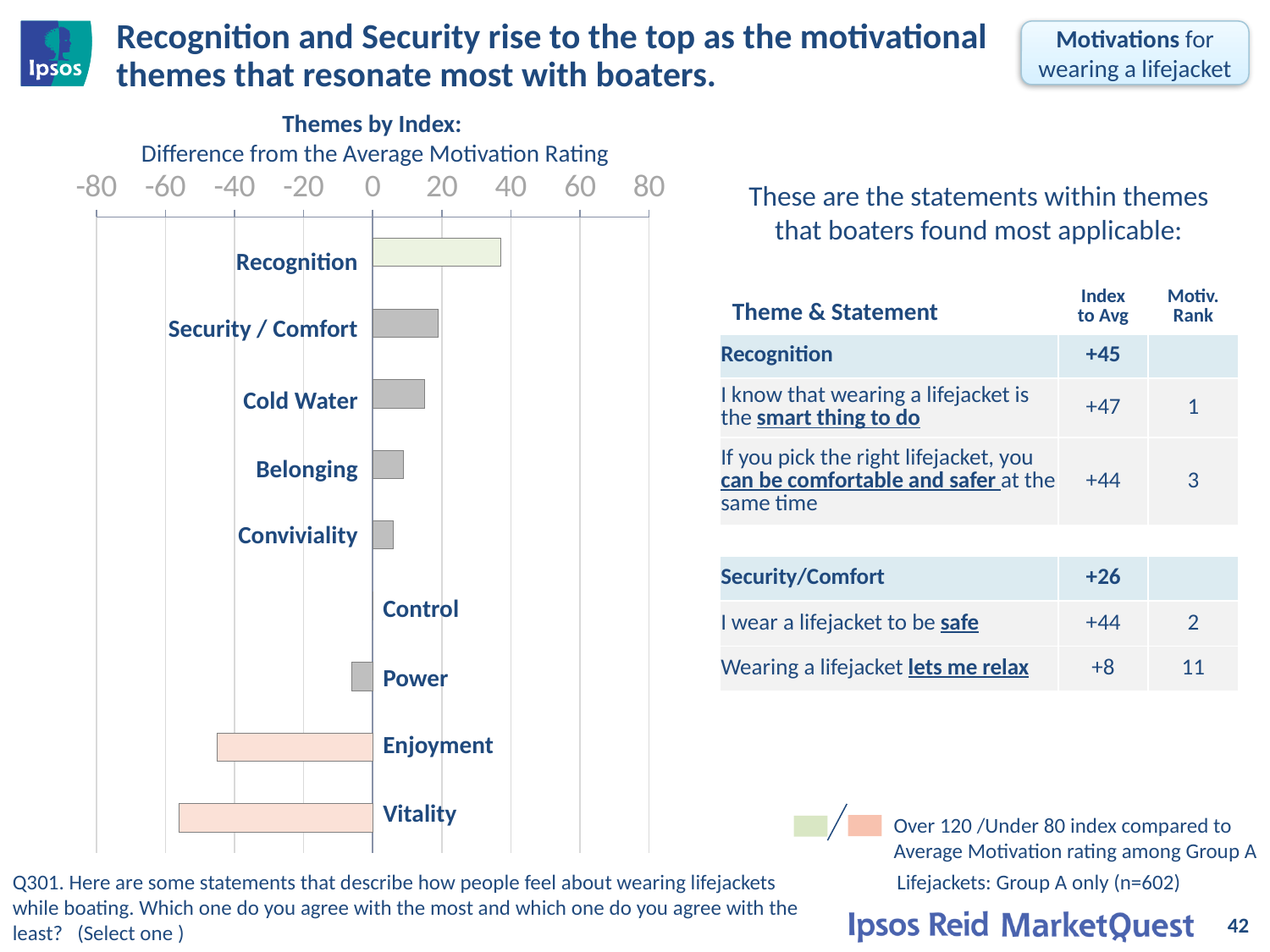
How many themes are plotted in the chart? 9 Is the value for Vitality greater or less than -40? less Is the value for Enjoyment greater or less than -20? less Which is larger, the value for Recognition or the value for Security / Comfort? Recognition Is the value for Power greater or less than 0? less Which theme has the lowest difference from the average motivation rating? Vitality What kind of chart is shown on the slide? bar chart Do the values rise or fall going from the top theme (Recognition) to the bottom theme (Vitality)? fall Which theme has the highest difference from the average motivation rating? Recognition What is the title of the chart? Themes by Index: Difference from the Average Motivation Rating Which is larger, the value for Enjoyment or the value for Vitality? Enjoyment